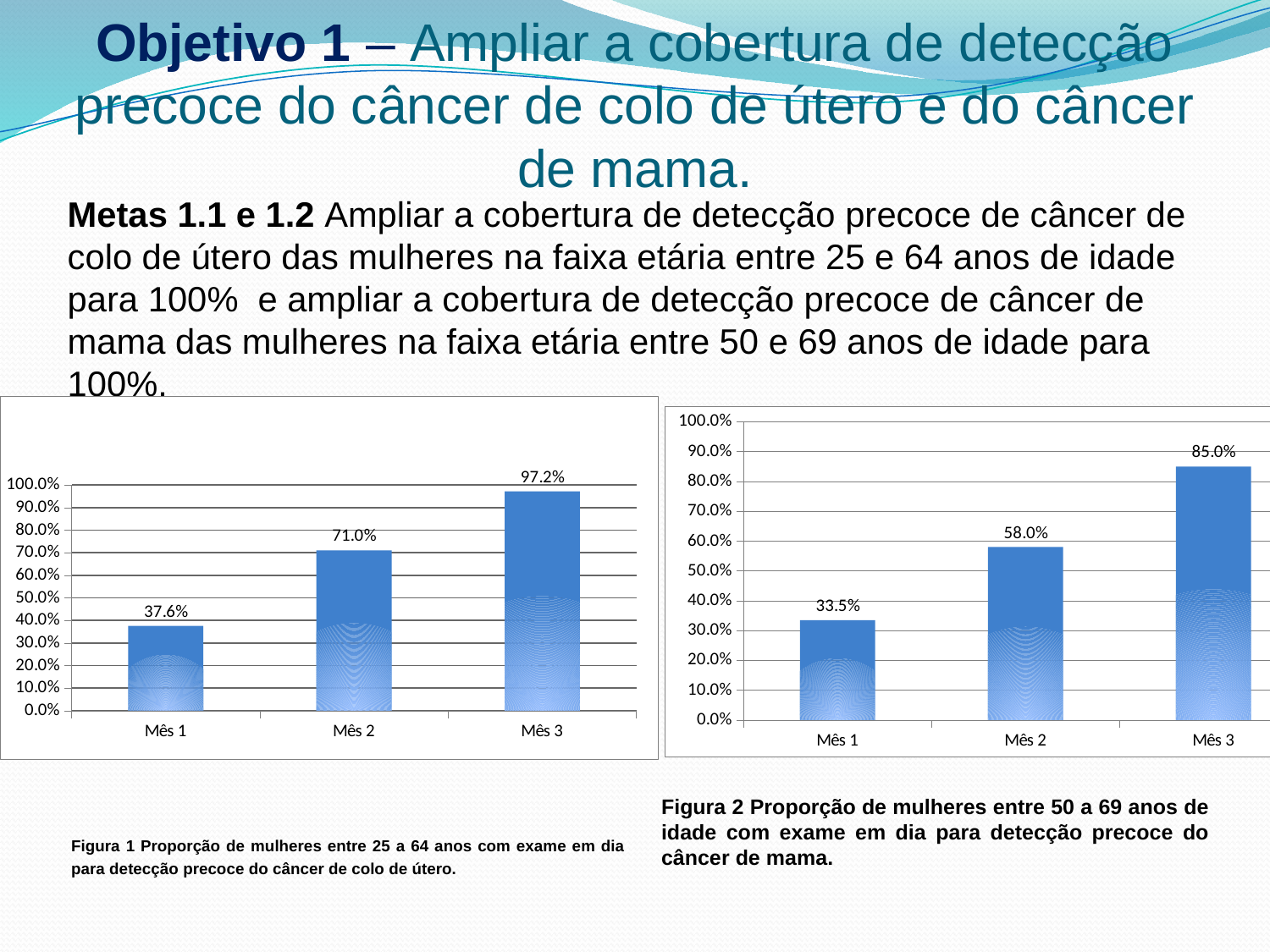
In the right chart (Figura 2), what is the difference between the values for Mês 3 and Mês 2? 27.0% In the left chart (Figura 1), do the values rise or fall from Mês 1 to Mês 3? Rise What is the maximum value shown on the y axis of the right chart (Figura 2)? 100.0% In the left chart (Figura 1), what is the value for Mês 2? 71.0% In the right chart (Figura 2), is the value for Mês 3 greater or less than 80.0%? greater In the left chart (Figura 1), which month has the highest value? Mês 3 How many months are shown on the x axis of the left chart (Figura 1)? 3 What kind of chart is the right chart (Figura 2)? Bar chart In the left chart (Figura 1), what is the difference between the values for Mês 3 and Mês 1? 59.6% Which is larger: the value for Mês 2 in the left chart (Figura 1) or the value for Mês 2 in the right chart (Figura 2)? Mês 2 in the left chart (Figura 1) In the right chart (Figura 2), which month has the lowest value? Mês 1 In the right chart (Figura 2), what is the value for Mês 1? 33.5%